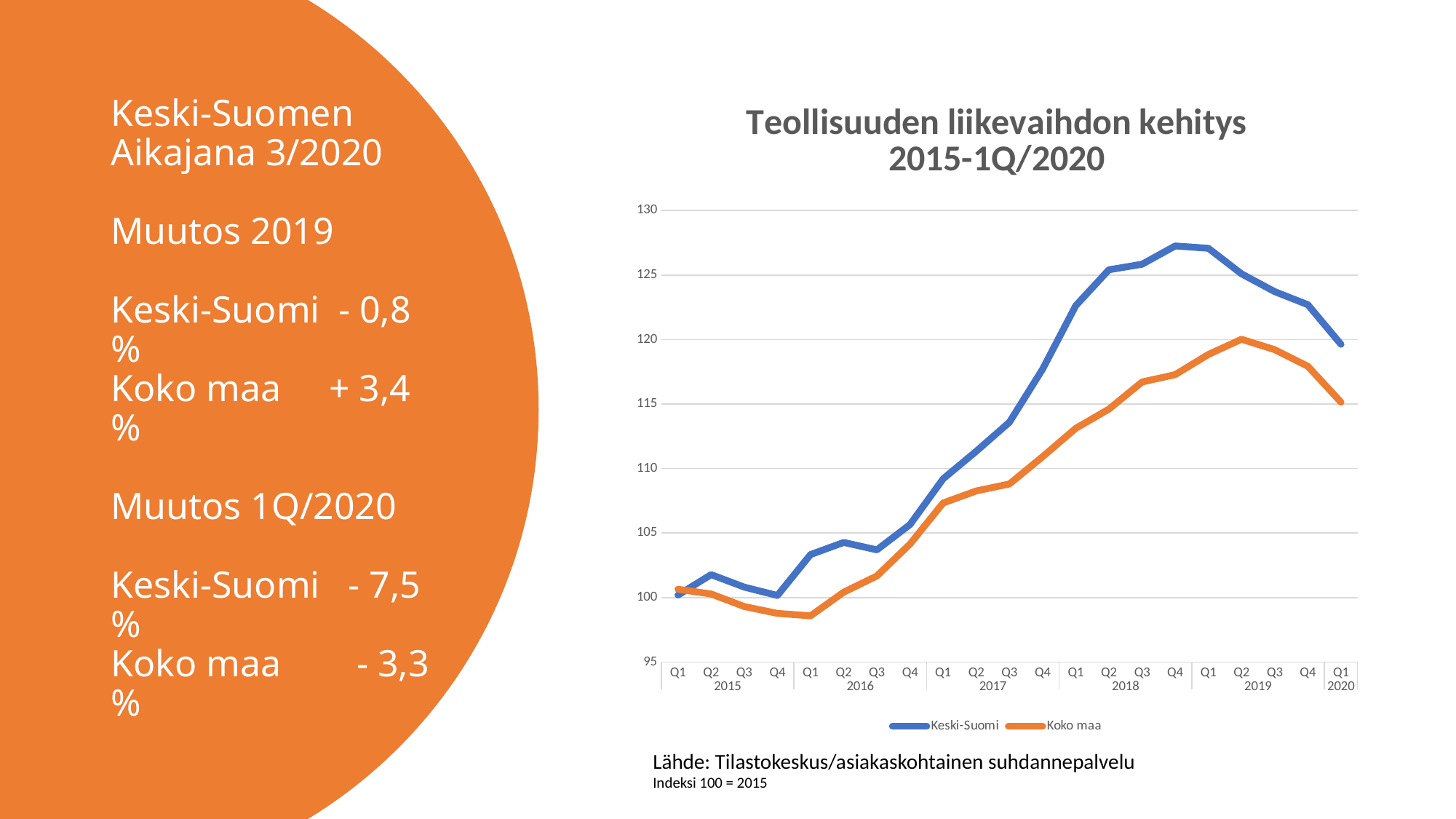
How many quarterly data points are plotted along the x axis of the chart? 21 Is the value for Keski-Suomi in Q4 2018 greater or less than 125? greater Is the value for Koko maa in Q1 2020 greater or less than 120? less Does the Koko maa series rise or fall from Q2 2019 to Q1 2020? fall In which quarter does the Koko maa series reach its highest value? Q2 2019 Is the value for Keski-Suomi in Q1 2017 greater or less than 105? greater How many series does the legend of the chart list? 2 What kind of chart is shown on the slide? line chart In Q3 2017, which series has the higher value, Keski-Suomi or Koko maa? Keski-Suomi In Q2 2019, which series has the higher value, Keski-Suomi or Koko maa? Keski-Suomi What is the title of the chart? Teollisuuden liikevaihdon kehitys 2015-1Q/2020